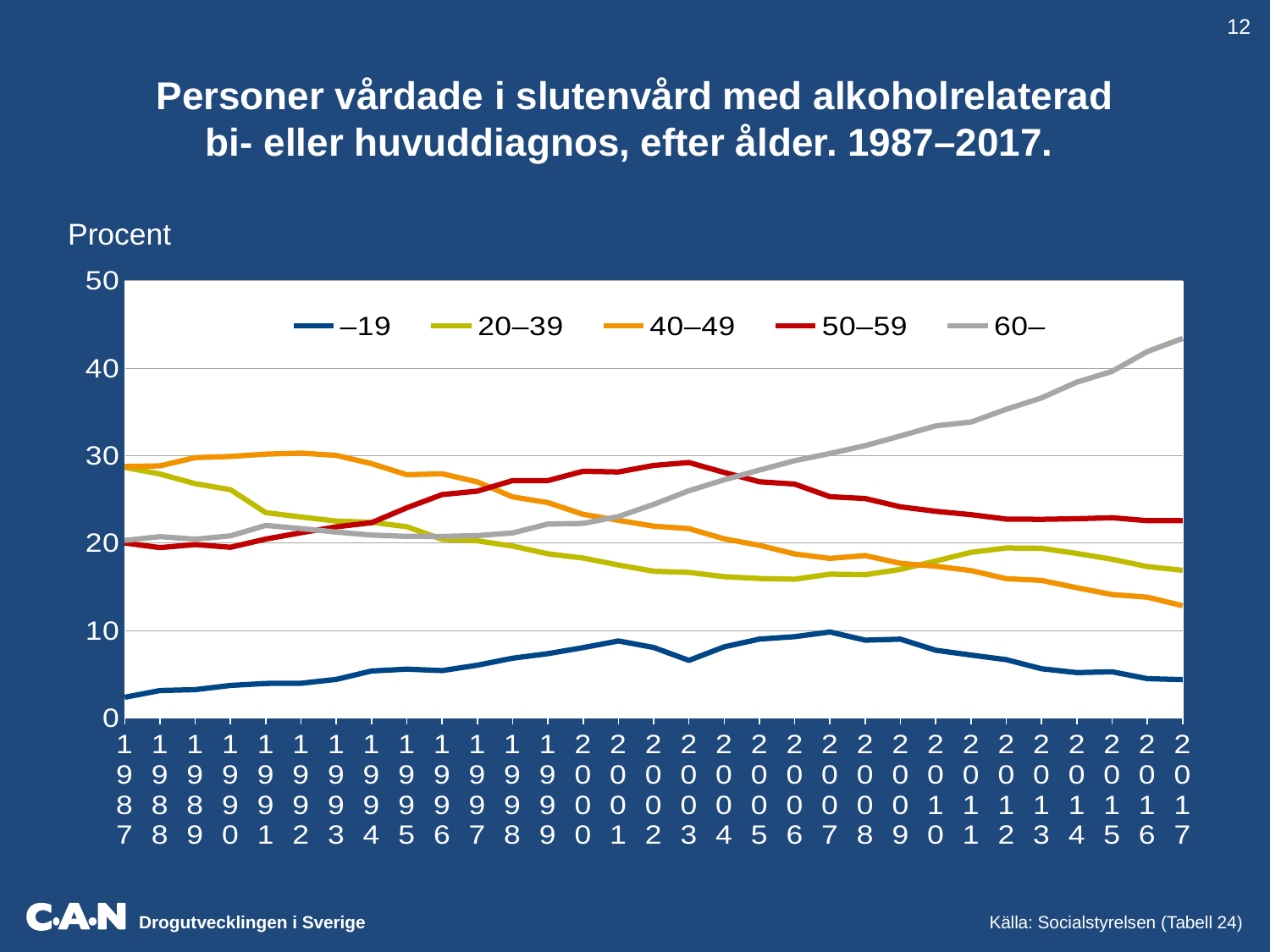
What is the label on the vertical axis of the chart? Procent Is the value for the –19 group in 2017 greater or less than 10? less Is the value for the 60– group in 2017 greater or less than 40? greater How many years are plotted along the x axis? 31 Which age group has the highest value in 2017? 60– Does the value for the 60– group rise or fall from 1987 to 2017? rise Is the value for the 40–49 group in 2017 greater or less than 20? less In 2017, which is larger: the value for 50–59 or the value for 20–39? 50–59 Which age group has the lowest value in 2017? –19 How many series does the legend list? 5 Which age group has the lowest value in 1987? –19 What kind of chart is shown on the slide? line chart